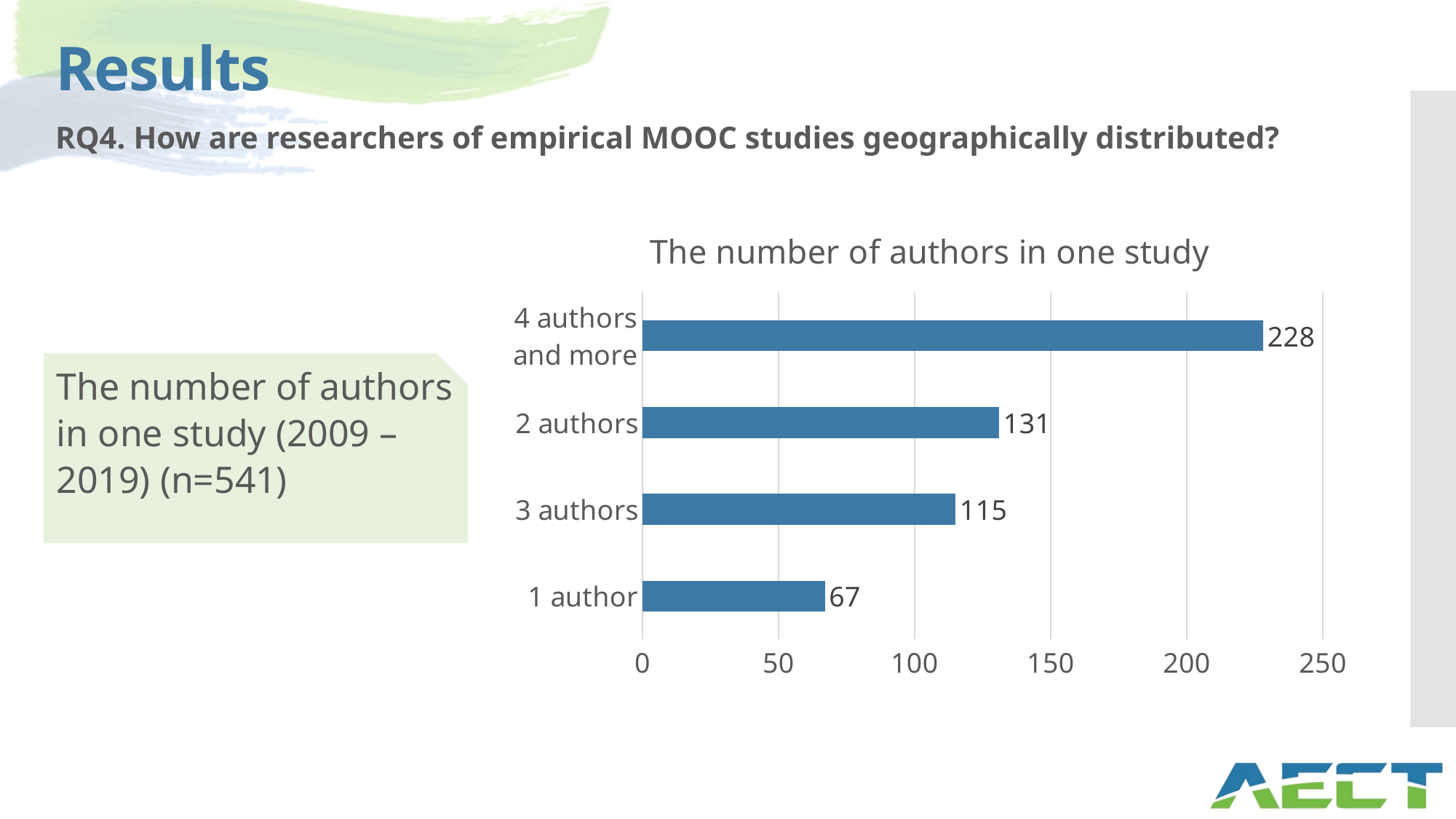
What is the value for '2 authors'? 131 What is the value for '3 authors'? 115 Is the value for '1 author' greater or less than 100? less What is the value for '1 author'? 67 What is the value for '4 authors and more'? 228 Which category has the lowest value? 1 author What is the difference between the values for '3 authors' and '1 author'? 48 How many categories are shown in the chart? 4 Which is larger, the value for '2 authors' or the value for '3 authors'? 2 authors What kind of chart is shown on the slide? bar chart Which category has the highest value? 4 authors and more What is the difference between the values for '4 authors and more' and '2 authors'? 97